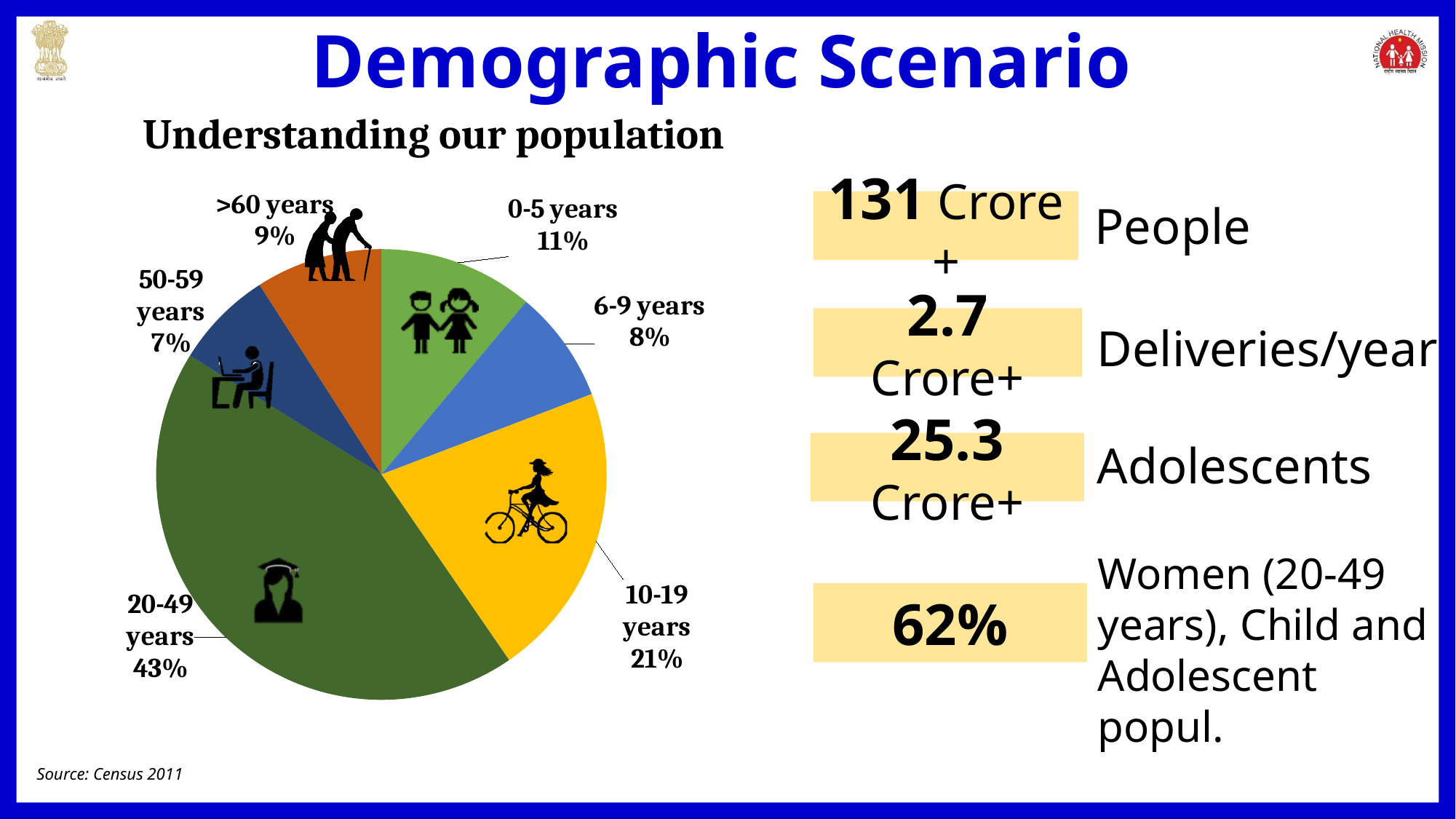
Which slice is larger, 6-9 years or 0-5 years? 0-5 years What is the combined share of the 0-5 years and 6-9 years slices? 19% What is the difference in percentage points between the 20-49 years and 10-19 years slices? 22 What percentage is shown for the >60 years group? 9% Which age group has the largest share of the pie chart? 20-49 years What is the value shown for the 0-5 years slice? 11% What share of the population is in the 20-49 years group in the pie chart? 43% What type of chart is used to show the population by age group? pie chart How many age groups are shown in the pie chart? 6 What percentage does the 10-19 years slice represent in the pie chart? 21% What is the source cited for the pie chart data? Census 2011 Which age group has the smallest share of the pie chart? 50-59 years